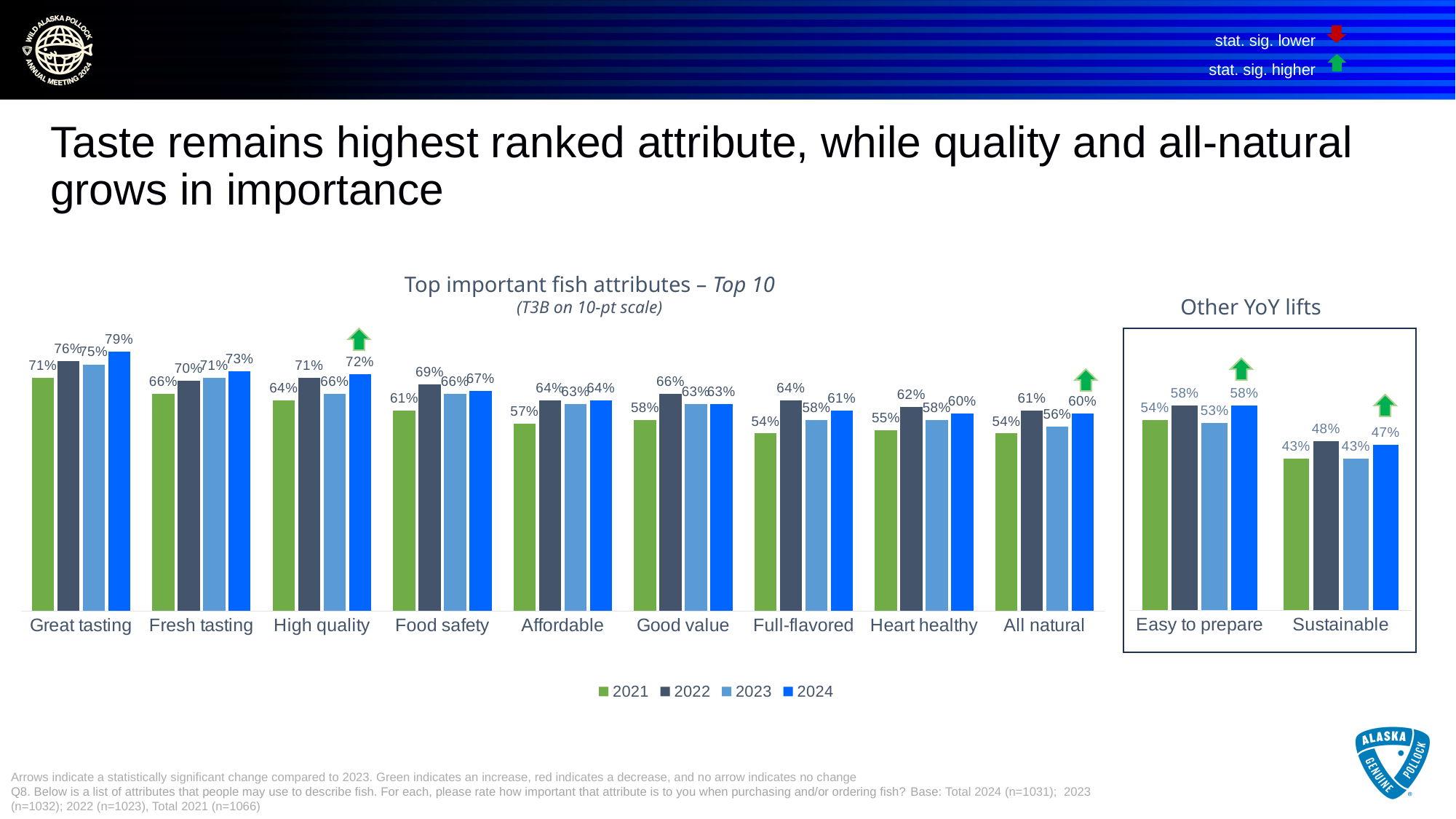
How many series does the legend list? 4 What is the 2024 value for Great tasting? 79% What is the 2023 value for All natural? 56% What is the difference between the 2024 and 2021 values for High quality? 8% What is the 2022 value for Food safety? 69% Which attribute has the highest 2024 value? Great tasting Which is larger for Full-flavored: the 2022 value or the 2024 value? 2022 What is the 2021 value for Sustainable? 43% What kind of chart is shown on the slide? Bar chart Which two attributes are grouped under the heading 'Other YoY lifts'? Easy to prepare and Sustainable How many attributes are shown on the x axis? 11 Which attribute has the lowest 2024 value? Sustainable